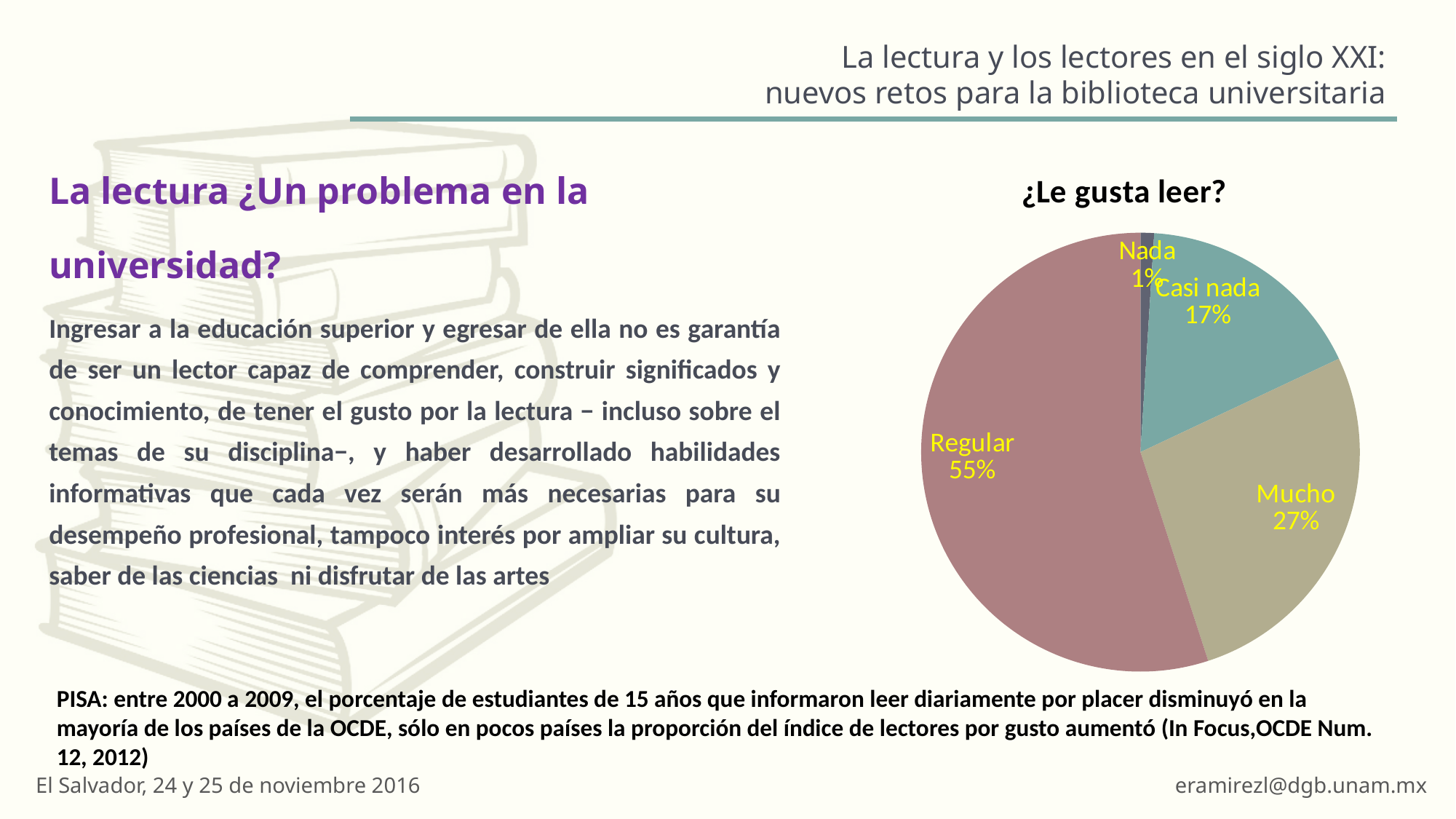
What percentage of the pie is labelled Mucho? 27% What is the difference in percentage points between the Regular and Mucho slices? 28 How many slices does the pie chart have? 4 What percentage of the pie is labelled Casi nada? 17% What percentage of the pie is labelled Regular? 55% What is the combined share of the Casi nada and Nada slices? 18% Which slice is larger, Mucho or Casi nada? Mucho Which slice of the pie chart is the largest? Regular Which slice of the pie chart is the smallest? Nada What kind of chart is shown on the slide? pie chart What percentage of the pie is labelled Nada? 1% What is the title of the pie chart? ¿Le gusta leer?